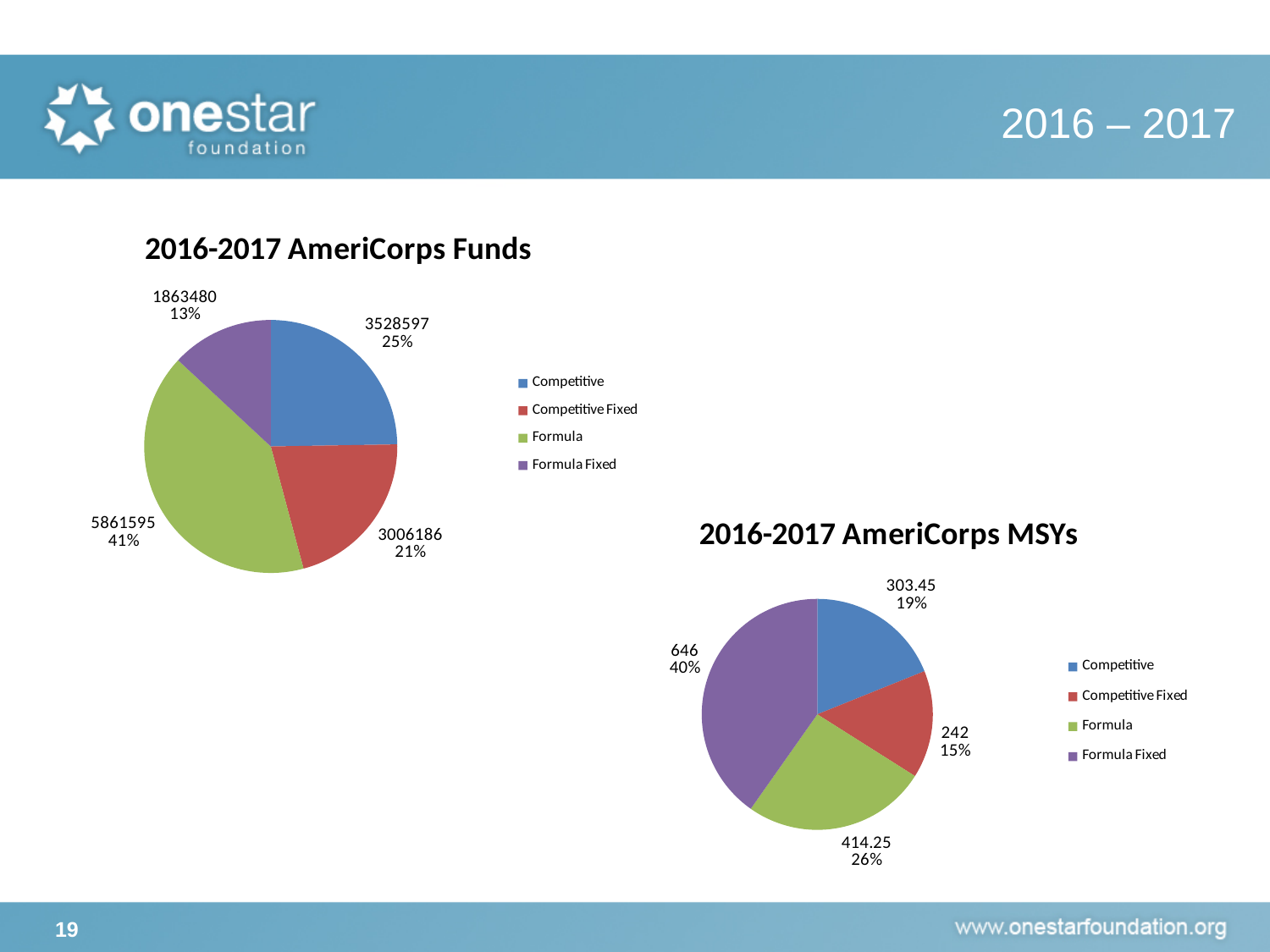
In the "2016-2017 AmeriCorps MSYs" chart, which is larger, Formula or Competitive Fixed? Formula In the "2016-2017 AmeriCorps Funds" chart, what is the difference between the Competitive and Competitive Fixed values? 522411 In the "2016-2017 AmeriCorps Funds" chart, how many categories does the legend list? 4 In the "2016-2017 AmeriCorps Funds" chart, what share of the pie is Competitive Fixed? 21% In the "2016-2017 AmeriCorps Funds" chart, what colour is the Formula slice? Green In the "2016-2017 AmeriCorps MSYs" chart, what is the value for Formula Fixed? 646 In the "2016-2017 AmeriCorps Funds" chart, which category has the smallest slice? Formula Fixed In the "2016-2017 AmeriCorps MSYs" chart, which category has the largest slice? Formula Fixed In the "2016-2017 AmeriCorps MSYs" chart, what share of the pie is Competitive? 19% In the "2016-2017 AmeriCorps MSYs" chart, what is the difference between the Formula Fixed and Competitive Fixed values? 404 What type of chart is the "2016-2017 AmeriCorps MSYs" chart? Pie chart In the "2016-2017 AmeriCorps Funds" chart, what is the value for Formula? 5861595